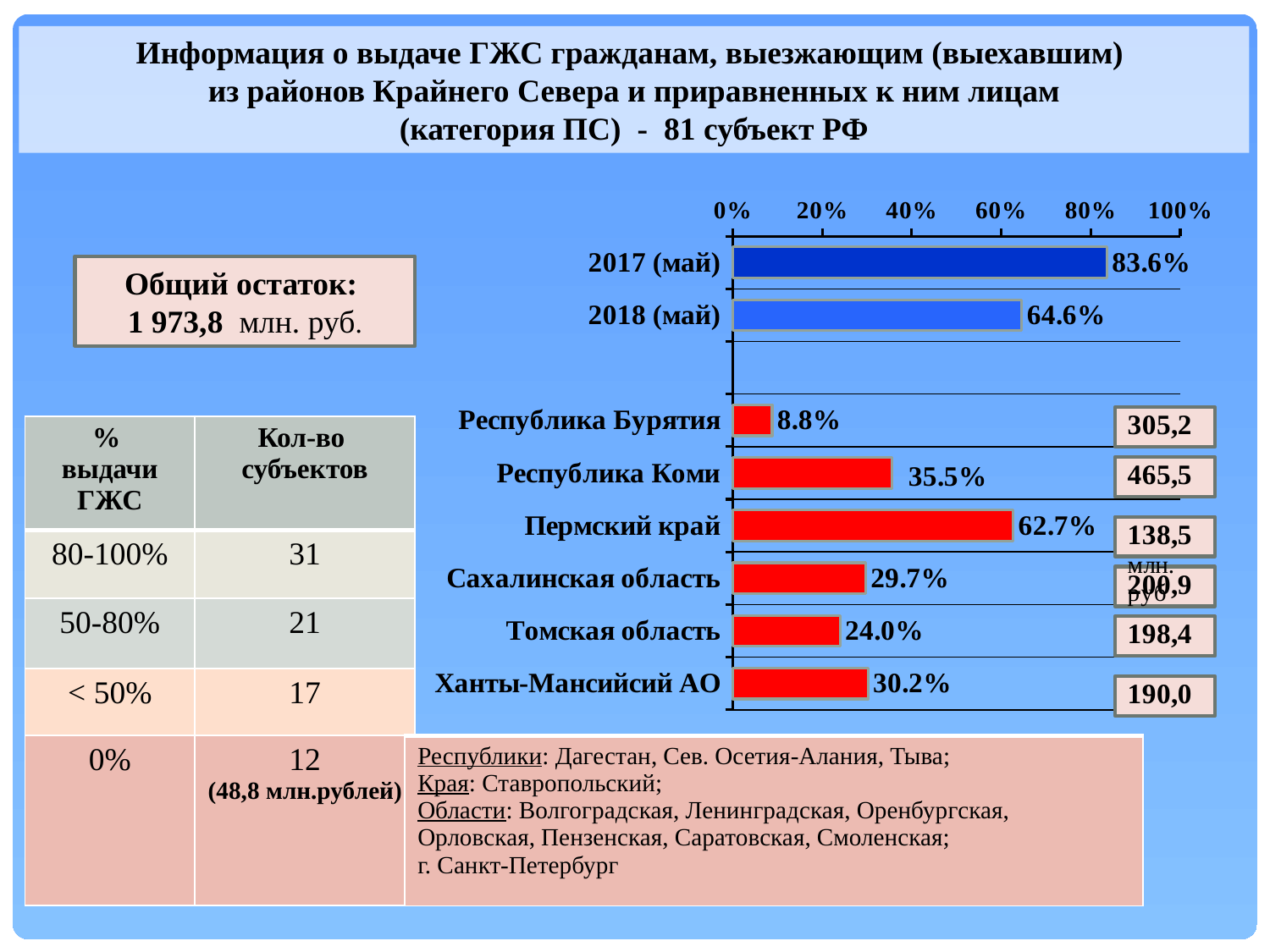
What is the value shown for 2018 (май) in the bar chart? 64.6% What is the value shown for 2017 (май) in the bar chart? 83.6% Which is larger: the value for Республика Коми or the value for Сахалинская область? Республика Коми Which category has the highest value in the bar chart? 2017 (май) Is the value for Ханты-Мансийсий АО greater or less than 40%? less Which category has the lowest value in the bar chart? Республика Бурятия What is the value shown for Республика Бурятия in the bar chart? 8.8% What is the value shown for Пермский край in the bar chart? 62.7% How many bars are plotted in the chart? 8 What is the value shown for Томская область in the bar chart? 24.0% What is the difference between the values for 2017 (май) and 2018 (май)? 19.0% What kind of chart is shown on the slide? bar chart